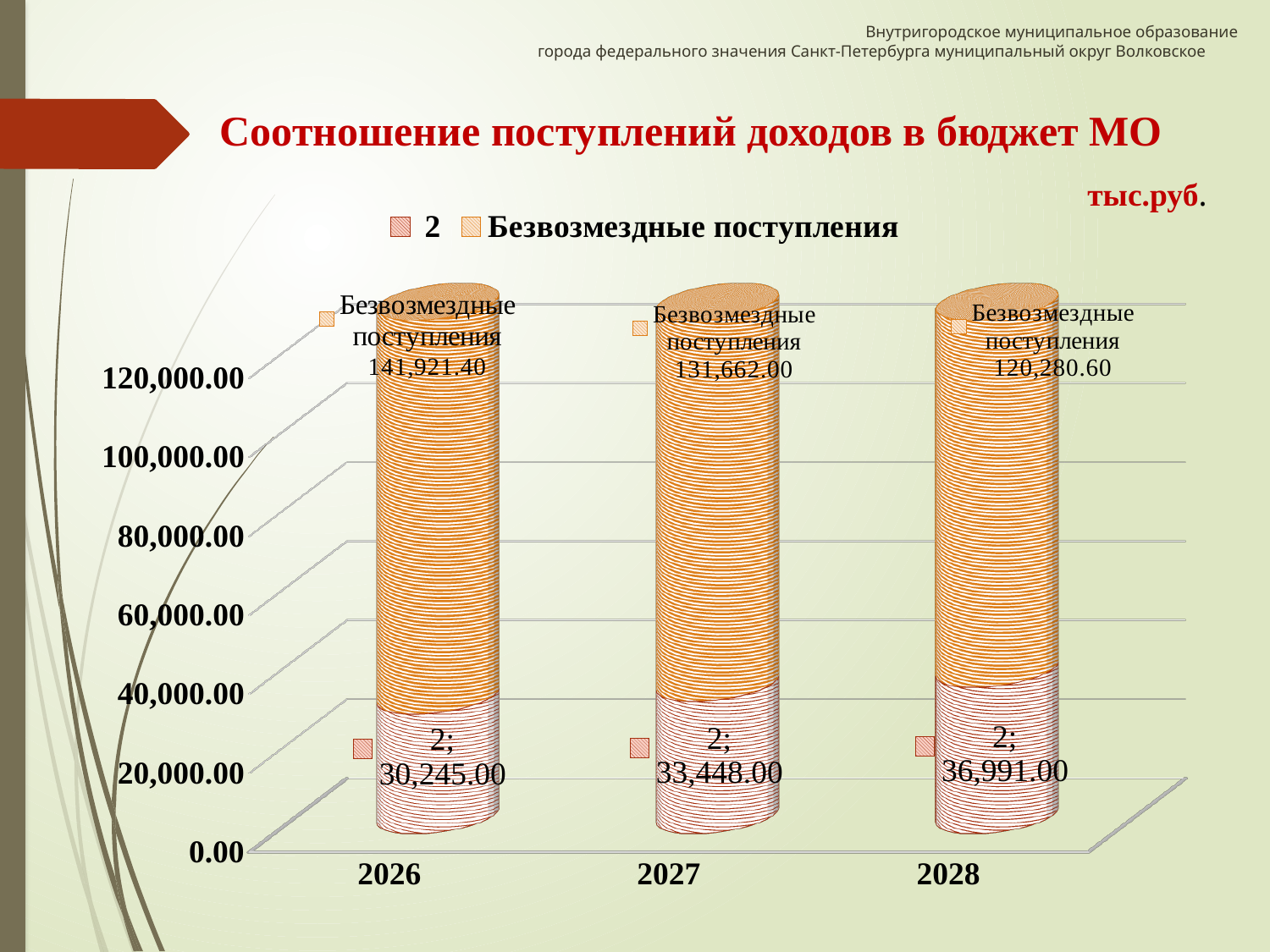
How many series does the legend list? 2 What is the value of Безвозмездные поступления for 2027? 131,662.00 What is the value of Безвозмездные поступления for 2026? 141,921.40 In which year is Безвозмездные поступления highest? 2026 What is the difference between Безвозмездные поступления in 2026 and 2027? 10,259.40 Which is larger: series 2 in 2027 or series 2 in 2026? 2027 What is the value of series 2 for 2028? 36,991.00 What is the difference between series 2 in 2028 and 2027? 3,543.00 How many years are shown on the x axis? 3 What kind of chart is shown on the slide? Stacked bar chart In which year is series 2 lowest? 2026 What is the total of the stacked bar for 2028? 157,271.60